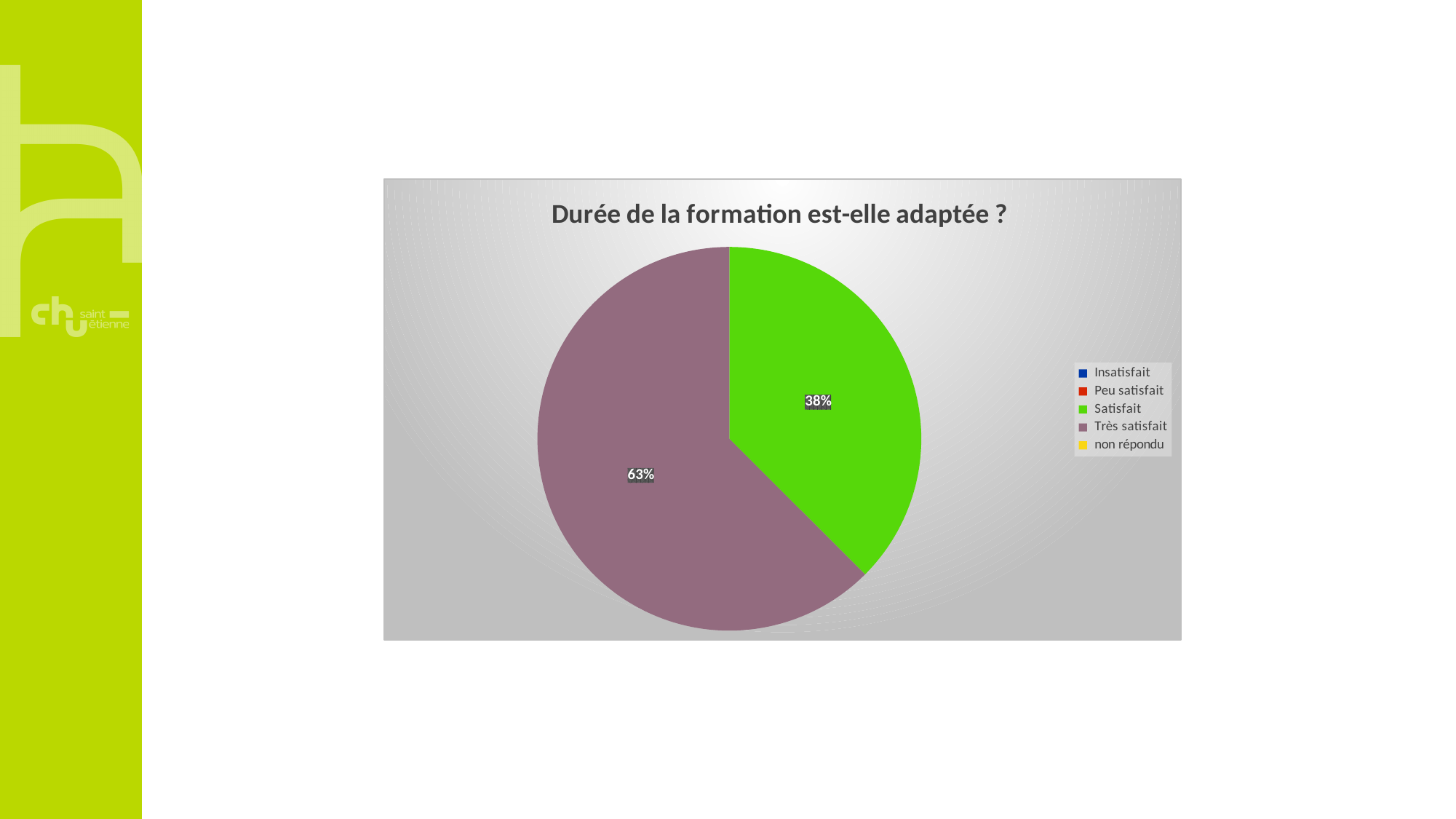
What is the title of the chart? Durée de la formation est-elle adaptée ? What type of chart is shown on the slide? pie chart What colour is the 'Satisfait' slice? green How many slices are visible in the pie? 2 How many entries does the legend list? 5 What is the difference in percentage points between the 'Très satisfait' and 'Satisfait' slices? 25 Which category has the largest share of the pie? Très satisfait Which is larger, the share for 'Satisfait' or the share for 'Très satisfait'? Très satisfait What percentage of the pie is labelled for 'Très satisfait'? 63% What percentage of the pie is labelled for 'Satisfait'? 38%